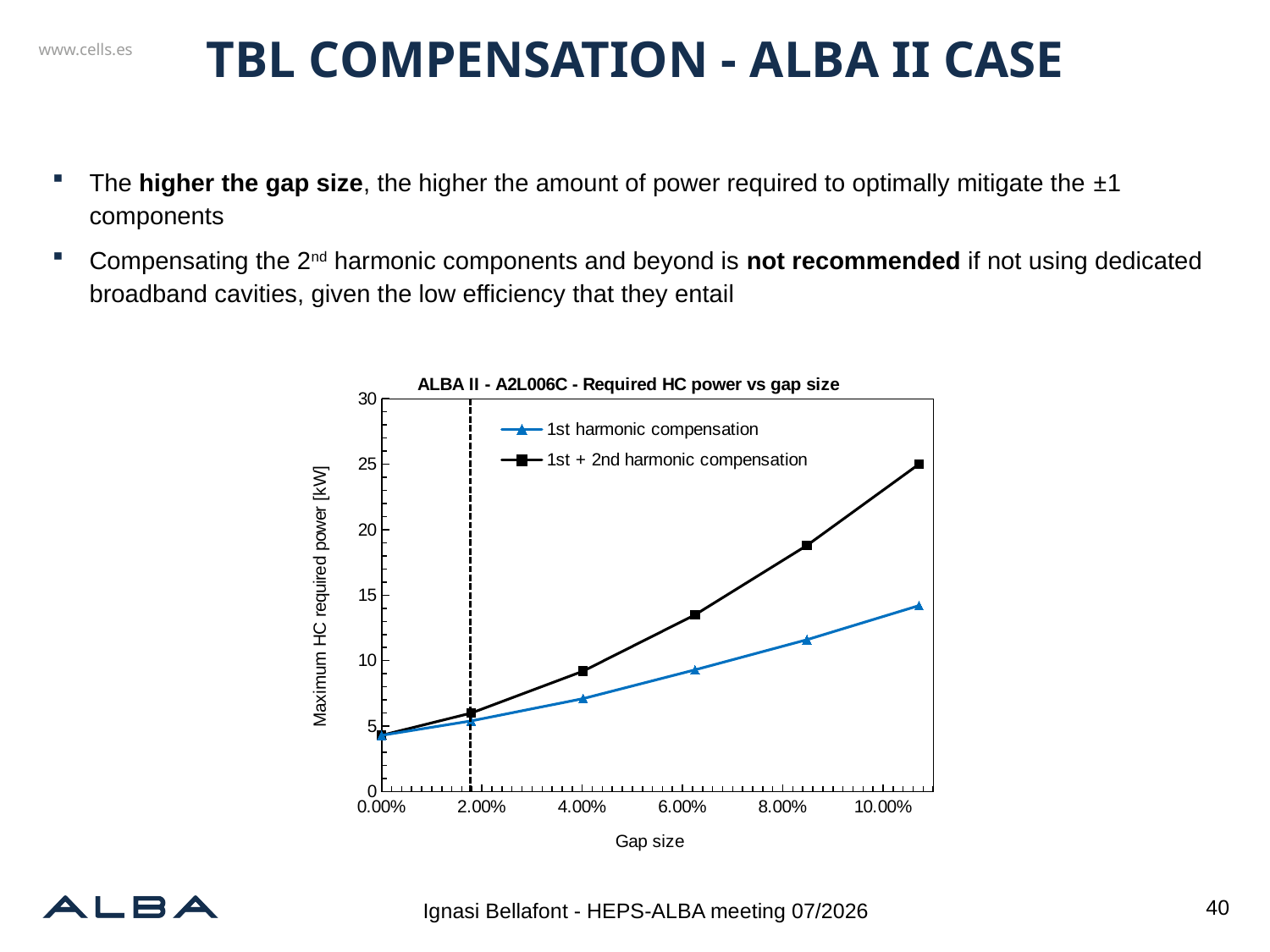
Do the values of the '1st + 2nd harmonic compensation' series rise or fall as gap size increases? rise Is the value of the '1st + 2nd harmonic compensation' series at a gap size of about 6% greater or less than 10? greater Which series reaches the highest required power on the chart? 1st + 2nd harmonic compensation Is the value of the '1st harmonic compensation' series at the largest gap size greater or less than 15? less At the largest gap size plotted, which series has the higher required power: '1st harmonic compensation' or '1st + 2nd harmonic compensation'? 1st + 2nd harmonic compensation Do the values of the '1st harmonic compensation' series rise or fall as gap size increases? rise How many data points are plotted for the '1st harmonic compensation' series? 6 What is the label of the vertical axis of the chart? Maximum HC required power [kW] What is the title of the chart? ALBA II - A2L006C - Required HC power vs gap size Is the value of the '1st + 2nd harmonic compensation' series at the largest gap size greater or less than 20? greater What kind of chart is shown on the slide? line chart How many series does the legend of the chart list? 2